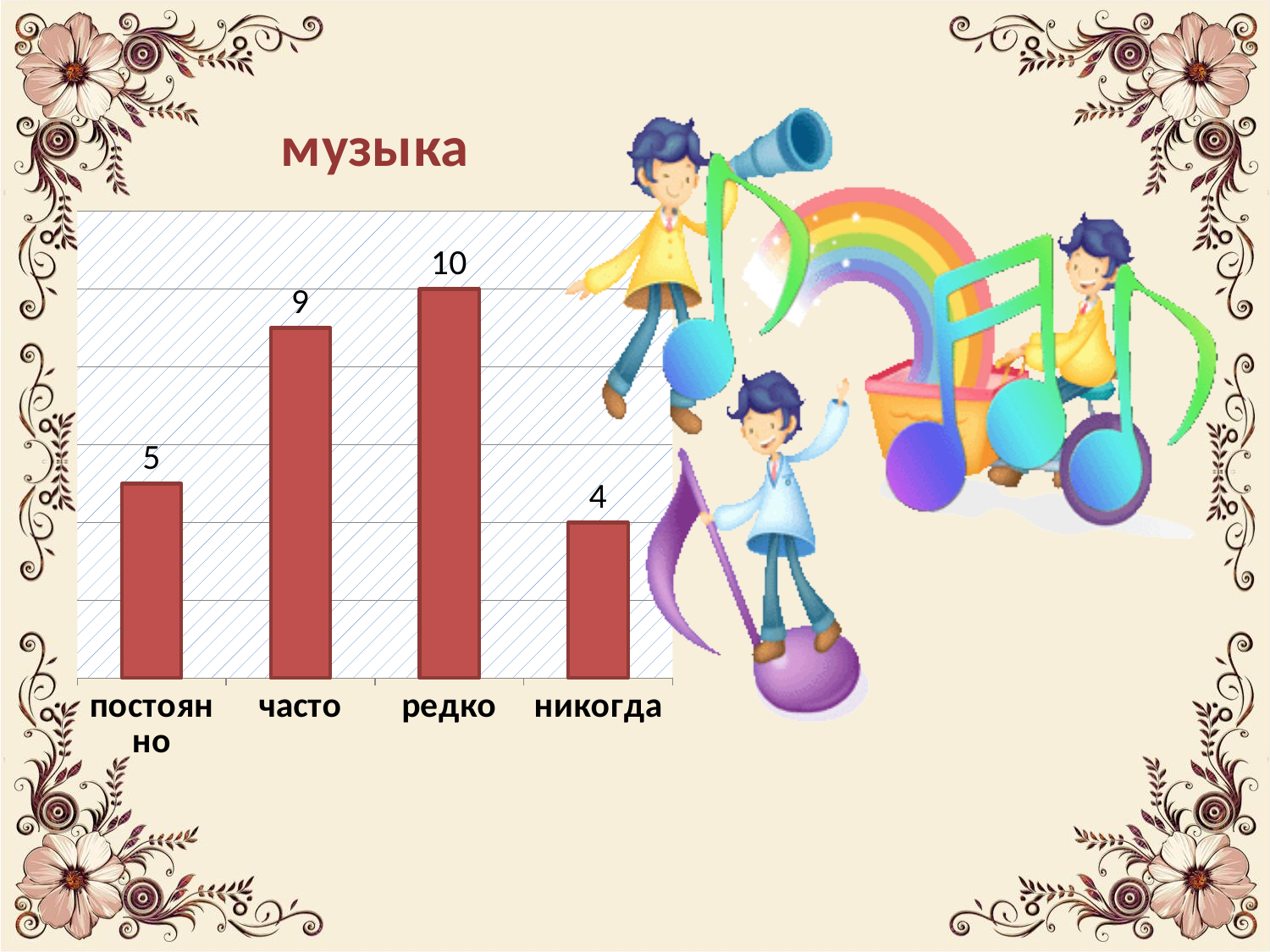
What is the difference between the values for "редко" and "никогда"? 6 What is the value for "никогда"? 4 What is the value for "часто"? 9 What is the difference between the values for "часто" and "постоянно"? 4 What is the title of the chart? музыка What kind of chart is shown on the slide? bar chart What is the value for "редко"? 10 Which category has the lowest value? никогда Which category has the highest value? редко How many categories are shown in the chart? 4 What is the value for "постоянно"? 5 Which is larger, the value for "часто" or the value for "постоянно"? часто